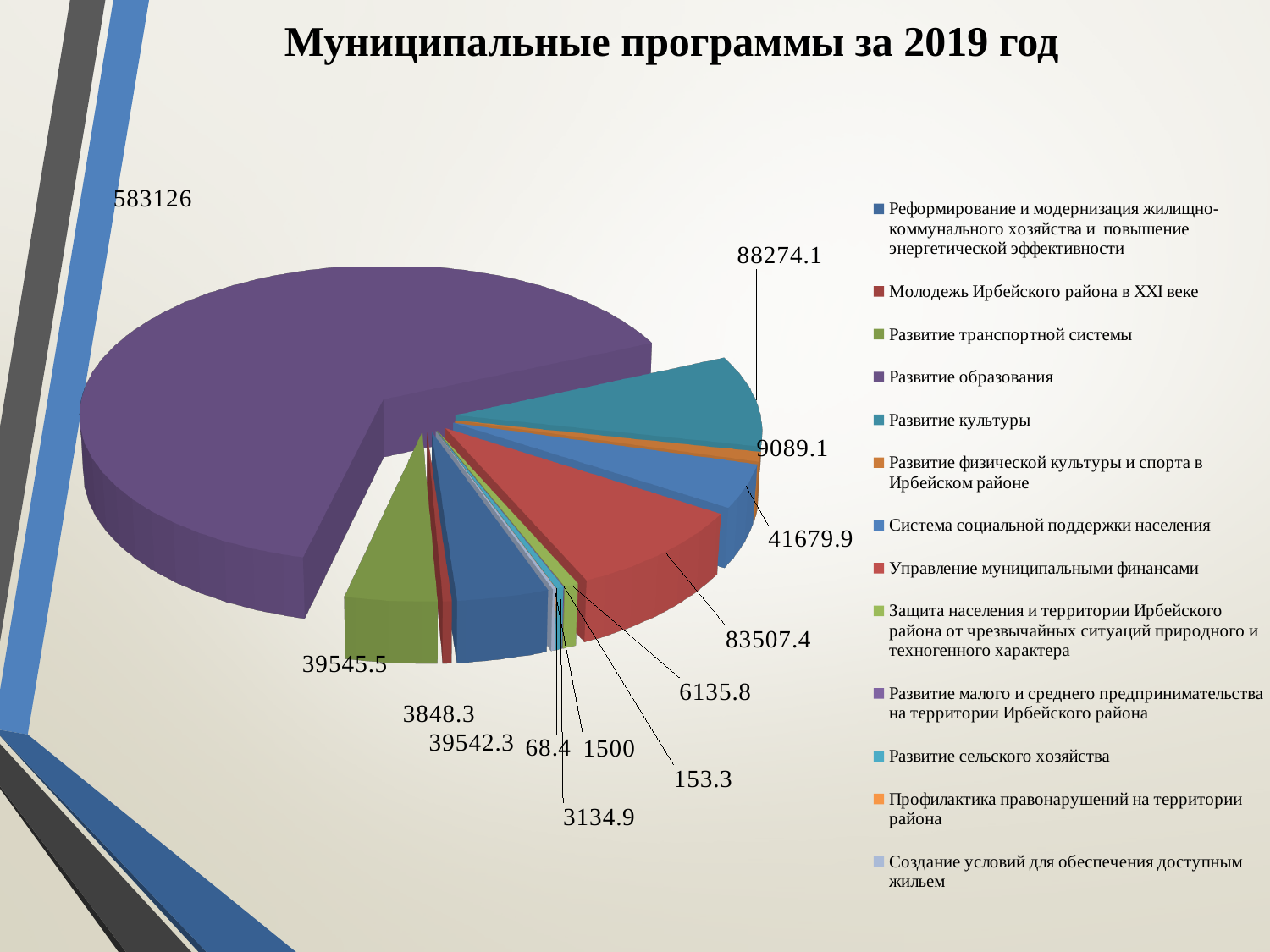
What is the value for Развитие образования? 583126 Which category has the largest slice of the pie? Развитие образования What kind of chart is shown on the slide? Pie chart What is the value for Управление муниципальными финансами? 83507.4 How many categories does the legend of the pie chart list? 13 What is the difference between the values for Развитие культуры and Управление муниципальными финансами? 4766.7 What is the title of the chart? Муниципальные программы за 2019 год What is the value for Развитие культуры? 88274.1 Which category has the smallest value in the pie chart? Профилактика правонарушений на территории района What is the value for Развитие физической культуры и спорта в Ирбейском районе? 9089.1 Which is larger: Развитие культуры or Управление муниципальными финансами? Развитие культуры What is the value for Система социальной поддержки населения? 41679.9